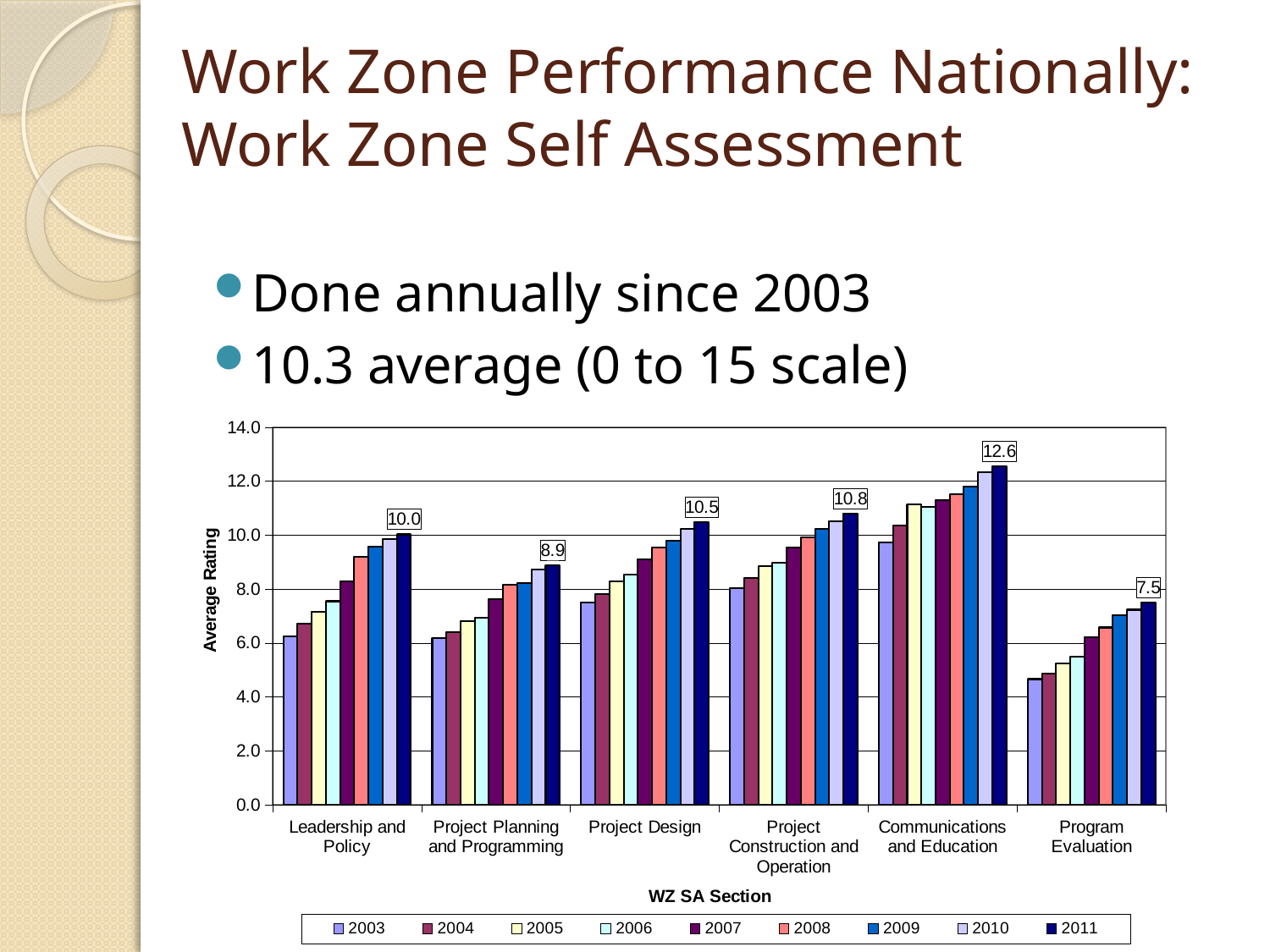
How many years (series) does the legend list? 9 Within each WZ SA Section, do the average ratings rise or fall from 2003 to 2011? Rise What is the 2011 average rating for Program Evaluation? 7.5 How many WZ SA Sections are shown on the x axis? 6 What kind of chart is shown on the slide? Bar chart What is the 2011 average rating for Project Planning and Programming? 8.9 Is the 2003 average rating for Program Evaluation greater or less than 6.0? less What is the 2011 average rating for Communications and Education? 12.6 Which has a higher 2011 average rating, Project Design or Leadership and Policy? Project Design Which WZ SA Section has the highest 2011 average rating? Communications and Education Which WZ SA Section has the lowest 2011 average rating? Program Evaluation What is the difference between the 2011 average ratings for Communications and Education and Program Evaluation? 5.1